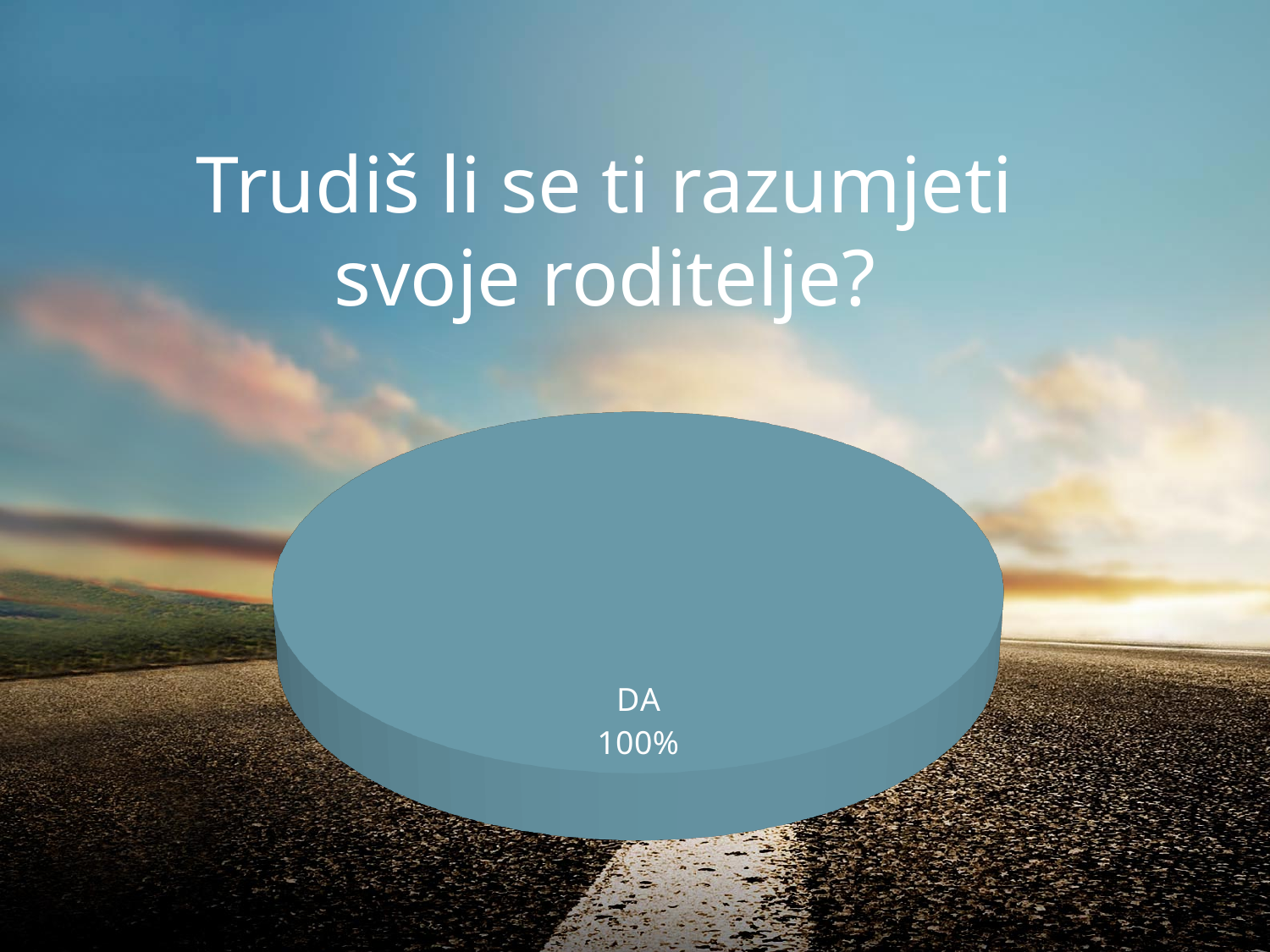
Which category is the largest in the pie chart? DA What share of the pie does the "DA" slice represent? 100% What is the title of the slide above the pie chart? Trudiš li se ti razumjeti svoje roditelje? What is the label of the only slice in the pie chart? DA How many slices does the pie chart have? 1 What is the value printed on the "DA" slice of the pie chart? 100% What kind of chart is shown on the slide? pie chart